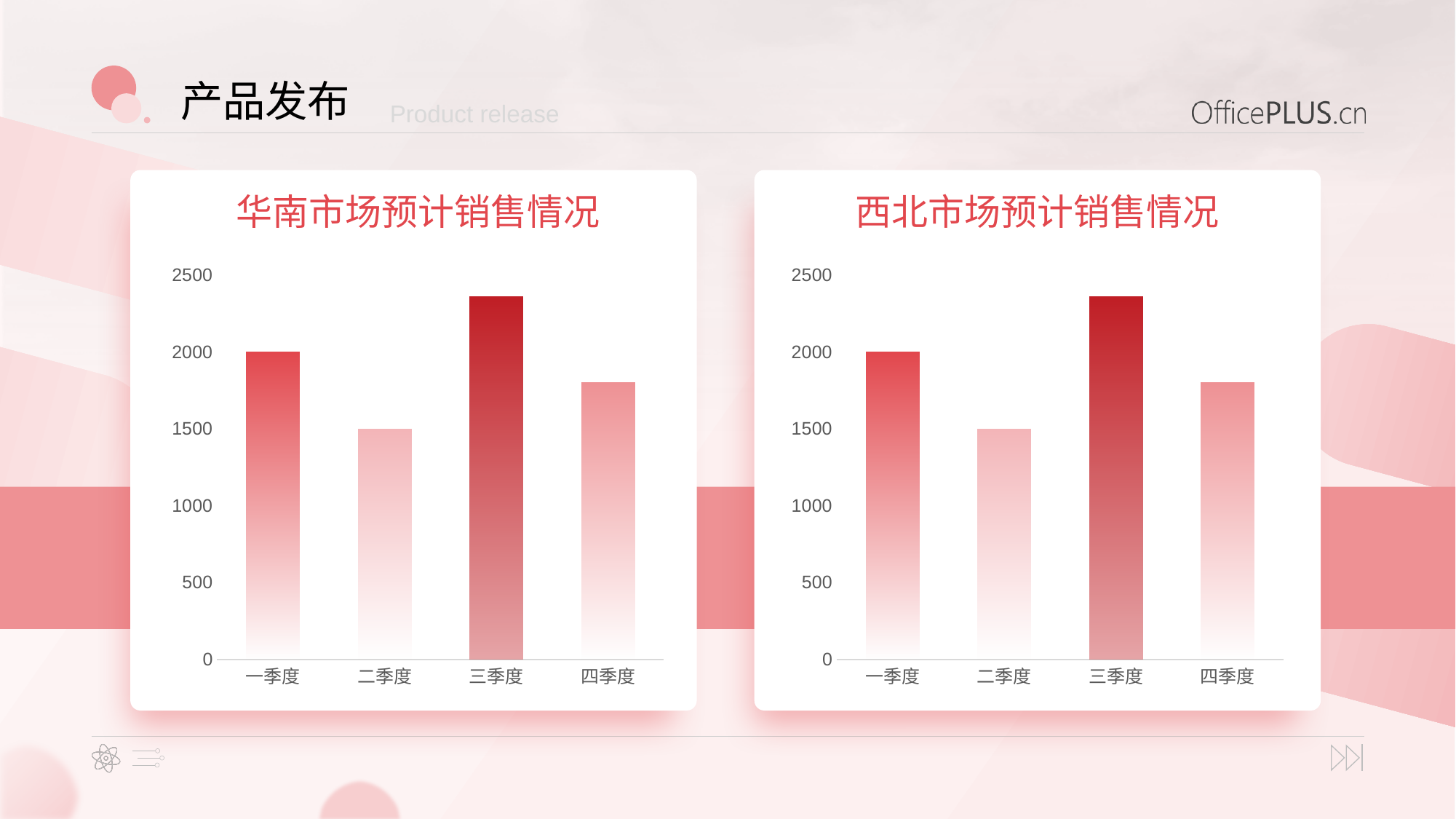
In the 西北市场预计销售情况 chart, which quarter has the lowest bar? 二季度 In the 华南市场预计销售情况 chart, what kind of chart is shown? bar chart In the 华南市场预计销售情况 chart, is the value for 三季度 greater or less than 2000? greater In the 西北市场预计销售情况 chart, which quarter has the highest bar? 三季度 In the 华南市场预计销售情况 chart, which is larger, the value for 一季度 or the value for 四季度? 一季度 In the 华南市场预计销售情况 chart, how many categories are on the x axis? 4 In the 华南市场预计销售情况 chart, which quarter has the highest bar? 三季度 In the 西北市场预计销售情况 chart, which is larger, the value for 二季度 or the value for 四季度? 四季度 In the 西北市场预计销售情况 chart, is the value for 二季度 greater or less than 2000? less What is the title of the chart on the right side of the slide? 西北市场预计销售情况 In the 华南市场预计销售情况 chart, is the value for 四季度 greater or less than 2000? less In the 华南市场预计销售情况 chart, which quarter has the lowest bar? 二季度